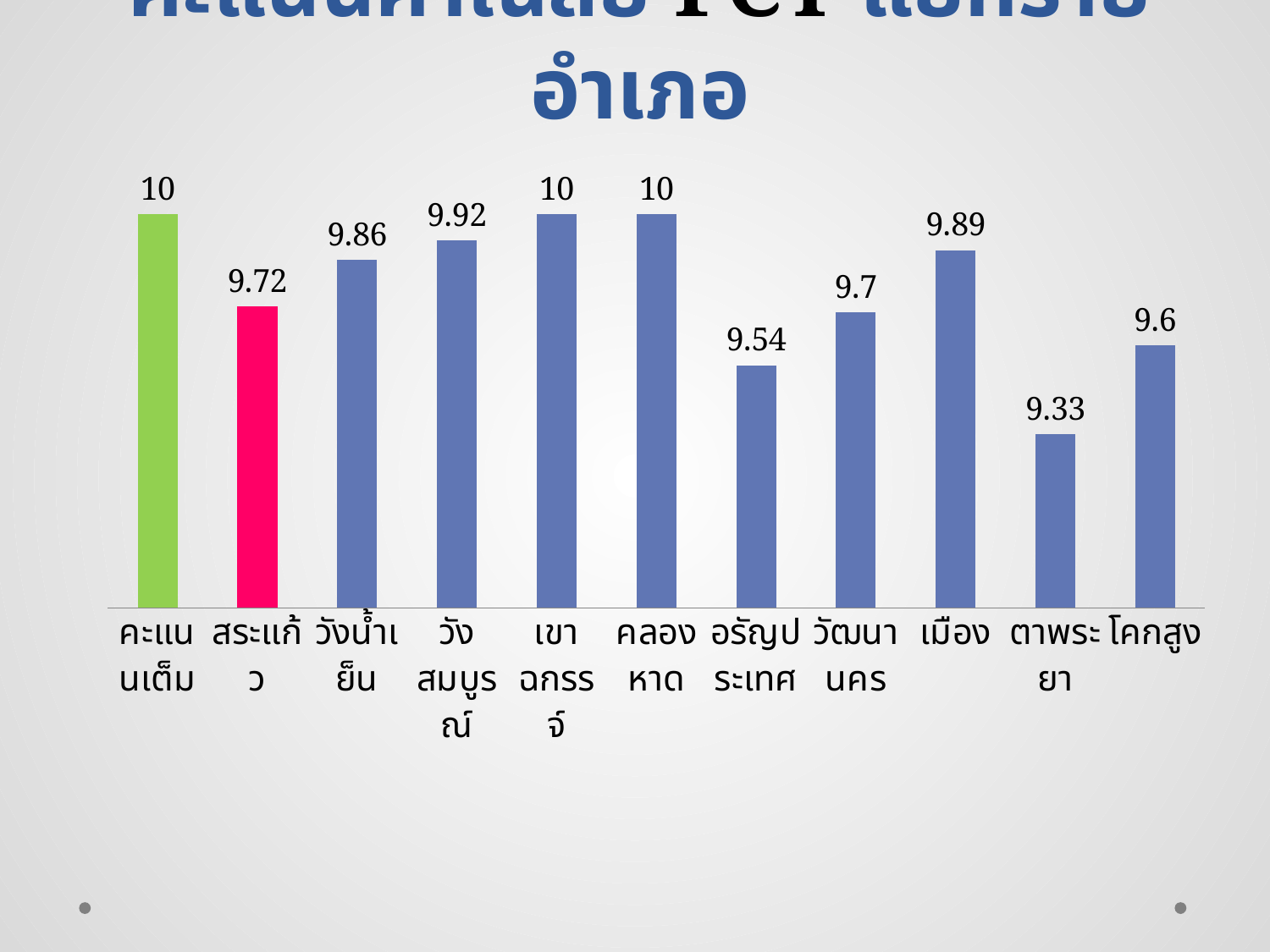
What is the value for ตาพระยา? 9.33 Which has a larger value, วังน้ำเย็น or วัฒนานคร? วังน้ำเย็น How many bars are plotted in the chart? 11 What colour is the bar for สระแก้ว? pink What is the value for เมือง? 9.89 Which has a larger value, โคกสูง or ตาพระยา? โคกสูง What is the difference between the values for คะแนนเต็ม and สระแก้ว? 0.28 Which category has the lowest value? ตาพระยา What is the difference between the values for วังสมบูรณ์ and โคกสูง? 0.32 What type of chart is shown on the slide? bar chart What is the value for อรัญประเทศ? 9.54 What is the value for สระแก้ว? 9.72